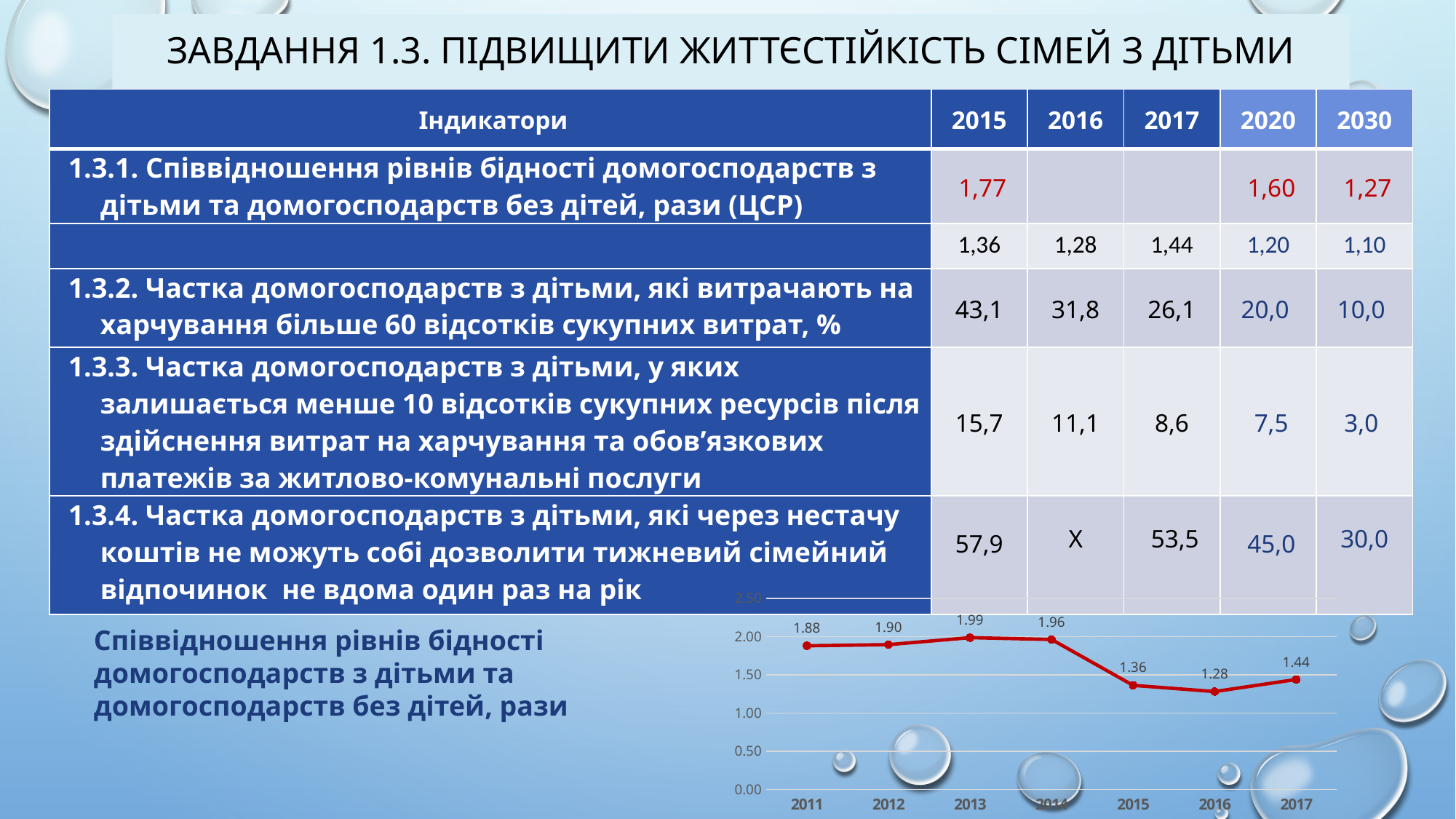
How many years are plotted on the x axis of the line chart? 7 In the line chart, what is the value for 2013? 1.99 In the line chart, what is the value for 2017? 1.44 In the line chart, what is the difference between the values for 2014 and 2015? 0.60 What kind of chart is shown at the bottom of the slide? line chart In the line chart, what is the value for 2011? 1.88 In the line chart, which year has the highest value? 2013 In the line chart, which is larger, the value for 2012 or the value for 2017? 2012 In the line chart, what is the value for 2016? 1.28 In the line chart, do the values rise or fall from 2014 to 2016? fall In the line chart, which year has the lowest value? 2016 In the line chart, is the value for 2015 greater or less than 1.50? less